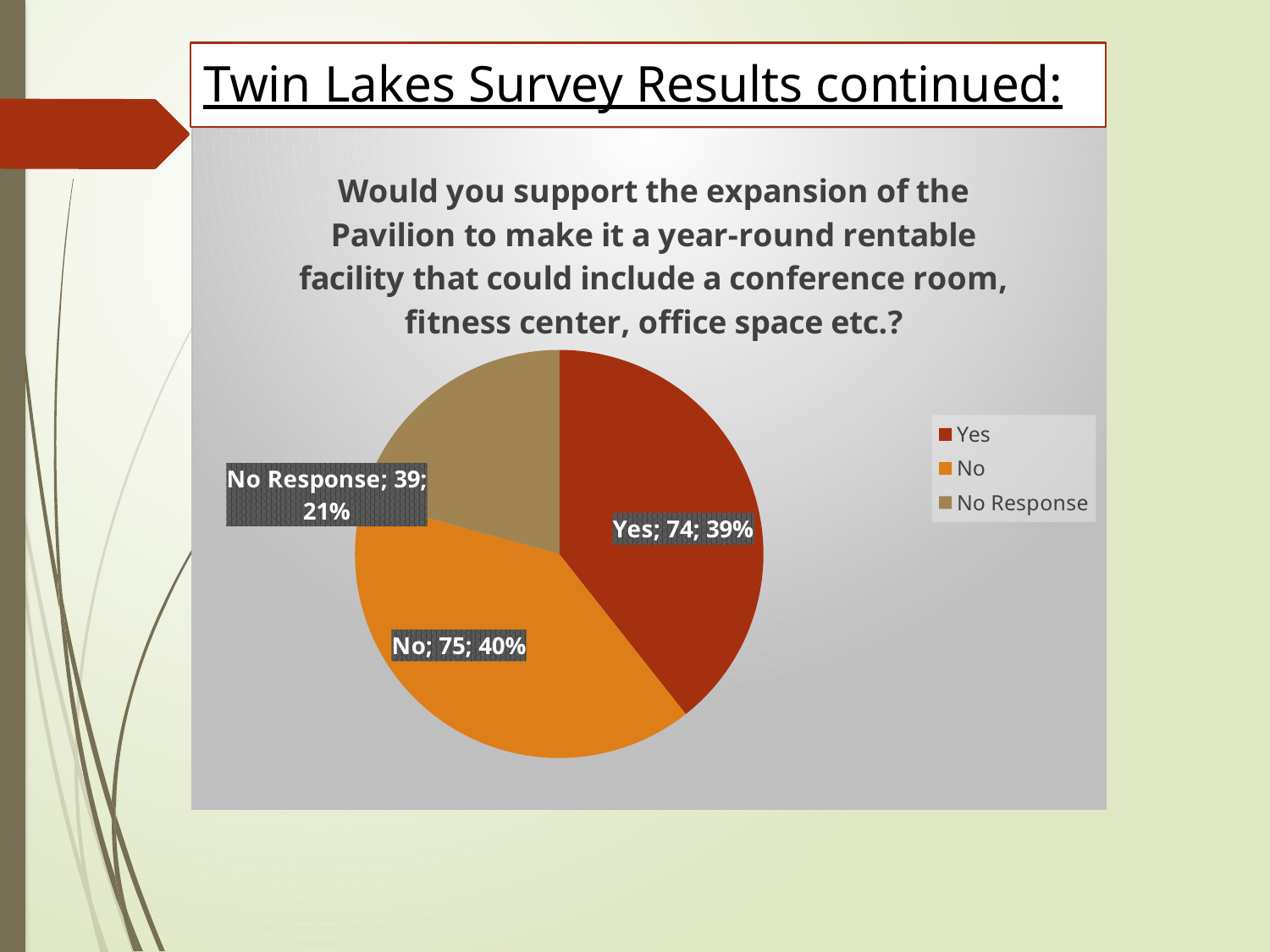
How many respondents answered Yes? 74 How many respondents answered No? 75 What kind of chart is shown on the slide? pie chart How many categories does the pie chart have? 3 How many respondents gave No Response? 39 What share of the pie does the No Response slice represent? 21% What colour is the Yes slice? dark red What share of the pie does the No slice represent? 40% Which category has the smallest count? No Response How many entries does the legend list? 3 What is the difference between the Yes count and the No Response count? 35 What share of the pie does the Yes slice represent? 39%